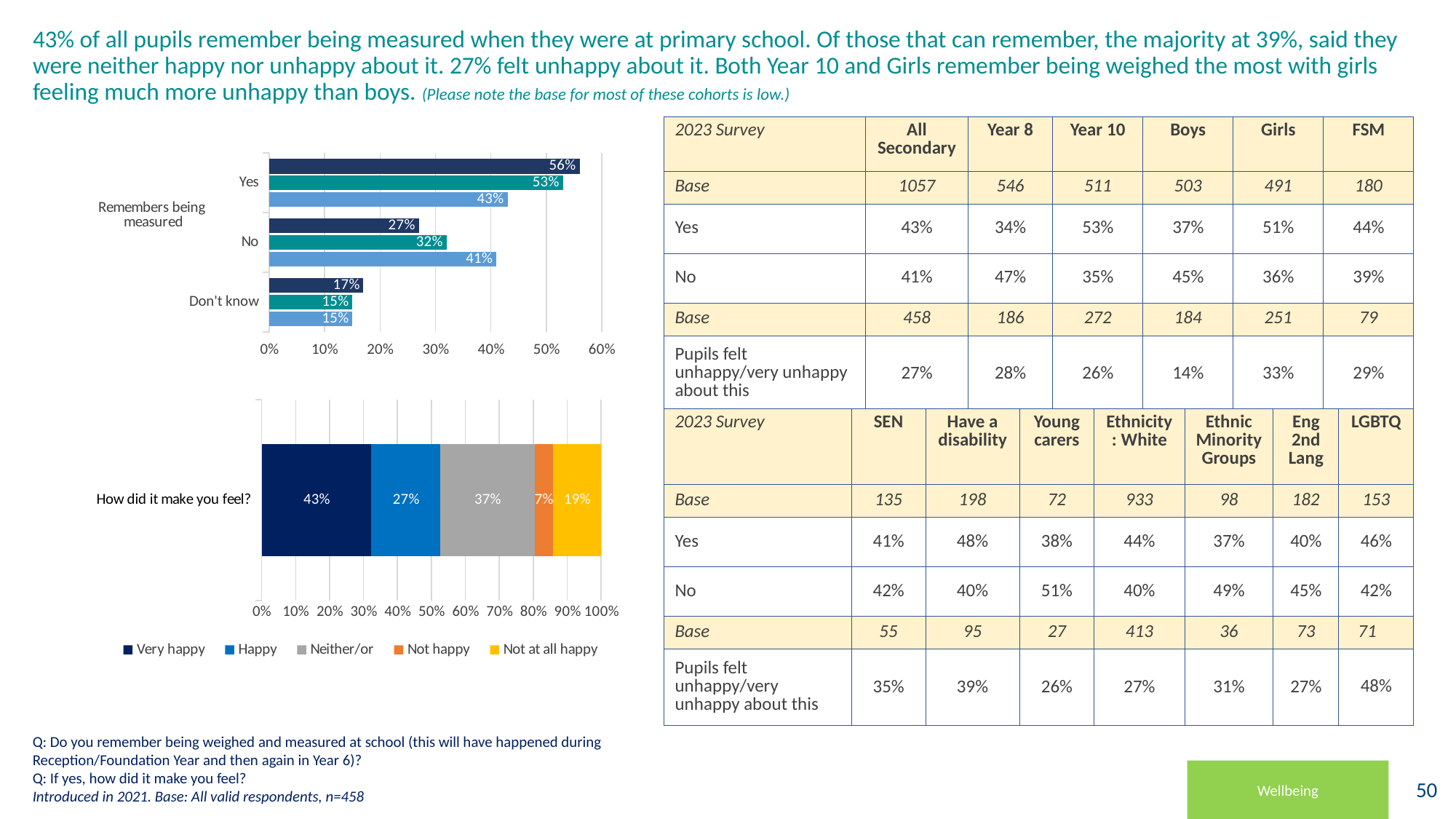
In the 'How did it make you feel?' chart, what is the value for 'Not happy'? 7% In the 'Remembers being measured' chart, what is the difference between the dark navy bar and the light blue bar for 'Yes'? 13 percentage points In the 'Remembers being measured' chart, what is the value of the teal bar for 'Don't know'? 15% In the 'Remembers being measured' chart, what is the value of the dark navy bar for 'No'? 27% How many series does the legend of the 'How did it make you feel?' chart list? 5 In the 'How did it make you feel?' chart, what is the value for 'Very happy'? 43% In the 'Remembers being measured' chart, what is the value of the light blue bar for 'Yes'? 43% In the 'How did it make you feel?' chart, which is larger, 'Happy' or 'Neither/or'? Neither/or In the 'Remembers being measured' chart, which category has the highest dark navy bar? Yes How many categories are shown on the y axis of the 'Remembers being measured' chart? 3 In the 'Remembers being measured' chart, which category has the lowest light blue bar? Don't know What kind of chart is the 'Remembers being measured' chart? Bar chart